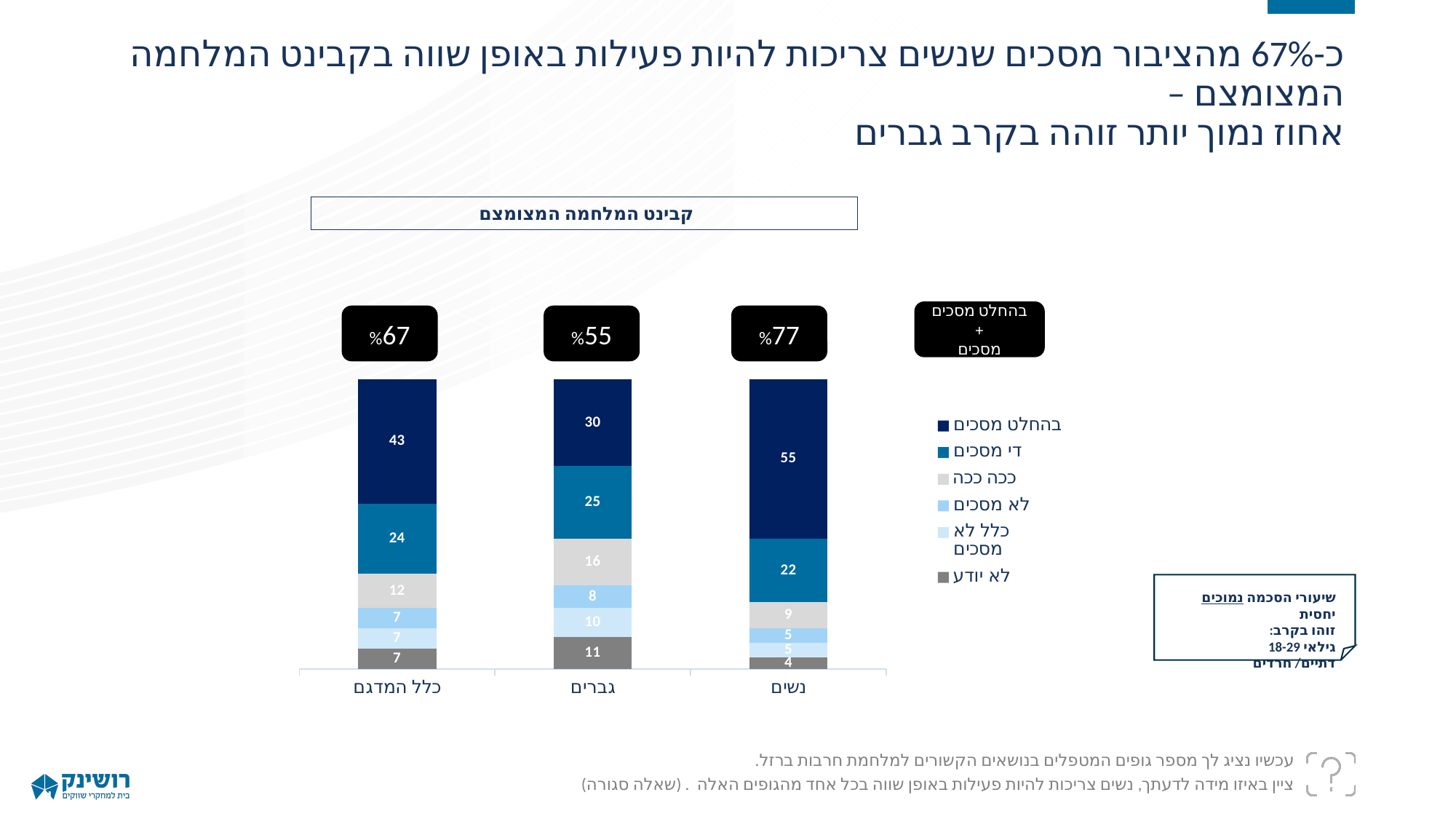
What combined percentage (בהחלט מסכים + מסכים) is shown above the bar for גברים? 55% What is the difference between the בהחלט מסכים values for נשים and גברים? 25 What is the value of בהחלט מסכים for נשים? 55 How many series does the chart legend list? 6 What is the value of לא יודע for כלל המדגם? 7 How many categories are shown on the x axis of the chart? 3 What is the value of די מסכים for גברים? 25 Which category has the highest value for בהחלט מסכים? נשים Which is larger: the ככה ככה value for גברים or for כלל המדגם? גברים What kind of chart is shown on the slide? Stacked bar chart Which category has the lowest value for לא יודע? נשים What is the total of the stacked bar for גברים? 100